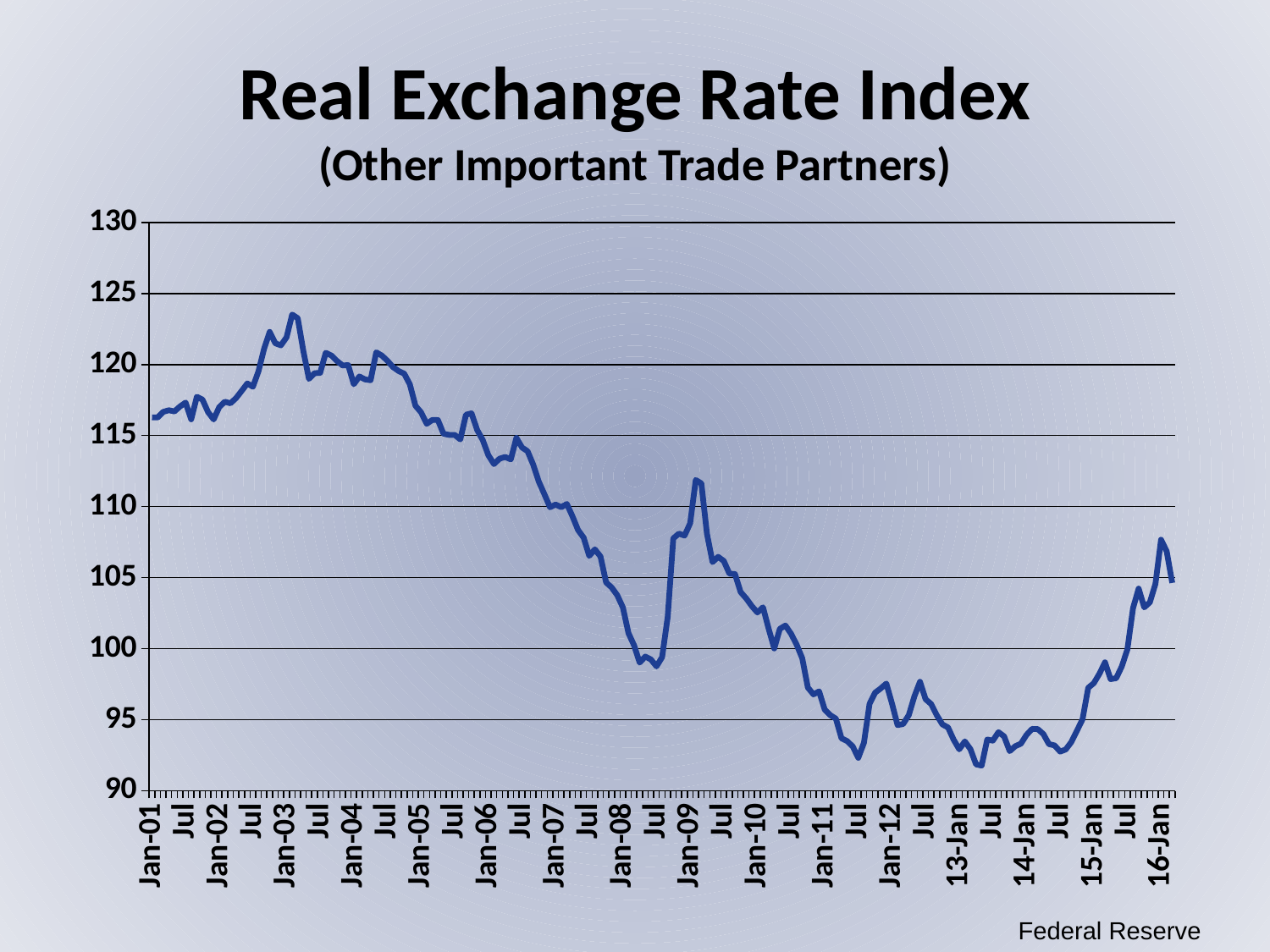
What is the title of the chart on the slide? Real Exchange Rate Index (Other Important Trade Partners) Does the index rise or fall between Jul-13 and 16-Jan? rise What kind of chart is shown on the slide? line chart Is the value at Jan-01 higher or lower than the value at 16-Jan? higher Does the index rise or fall between Jan-03 and Jul-08? fall Is the value at 16-Jan greater or less than 105? greater Is the value at Jul-13 greater or less than 95? less Is the value at Jan-03 greater or less than 120? greater What source is cited for the chart? Federal Reserve